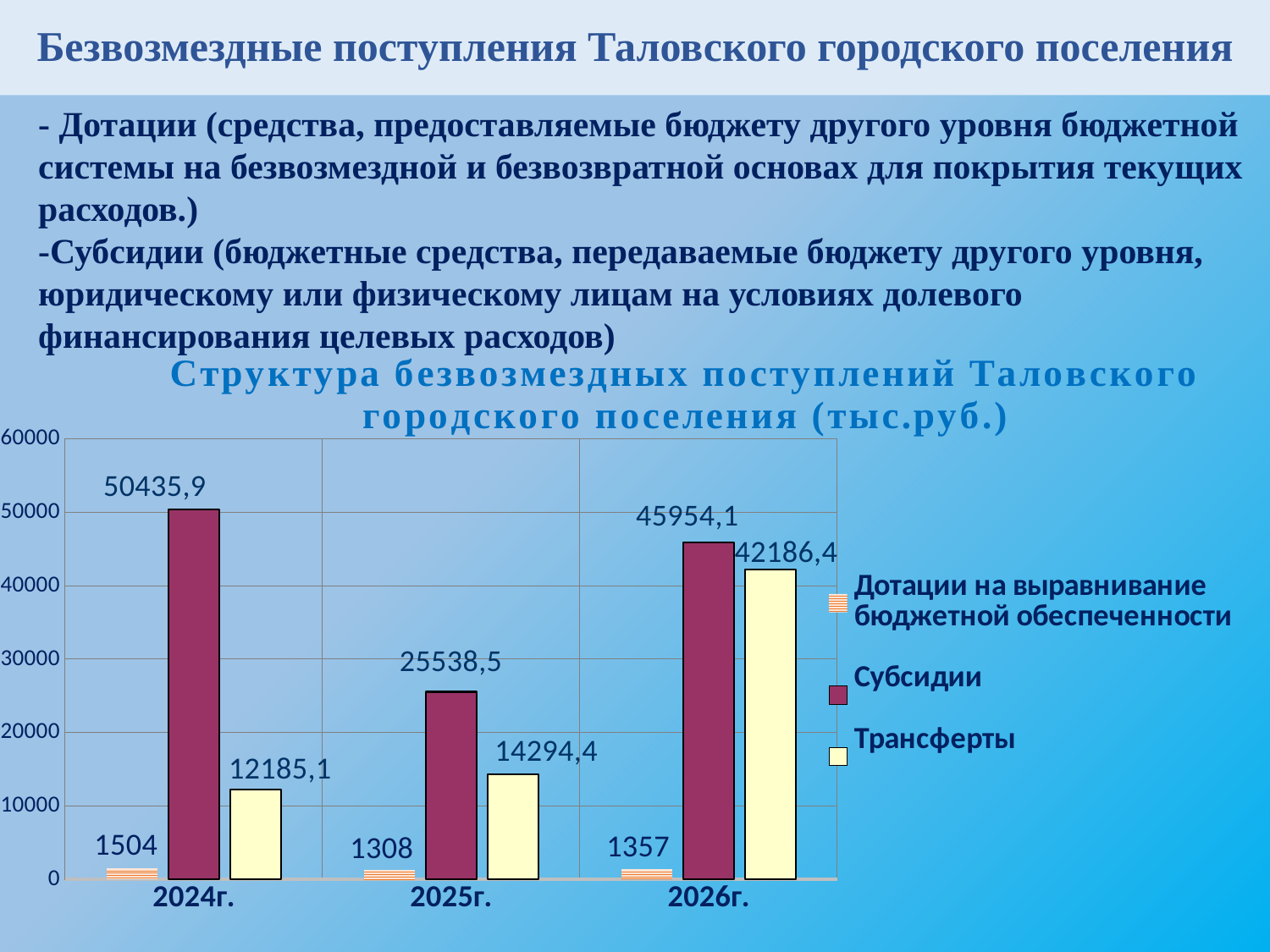
What is the difference between Дотации на выравнивание бюджетной обеспеченности in 2024г. and in 2025г.? 196 In which year is the value of Трансферты the highest? 2026г. In which year is the value of Субсидии the lowest? 2025г. What is the value of Субсидии for 2024г.? 50435,9 What is the value of Дотации на выравнивание бюджетной обеспеченности for 2025г.? 1308 What type of chart is shown on the slide? bar chart How many years are shown on the x axis? 3 Which is larger in 2026г.: Субсидии or Трансферты? Субсидии Is the value of Трансферты for 2025г. greater or less than 20000? less How many series does the legend list? 3 What is the difference between Субсидии in 2024г. and Субсидии in 2026г.? 4481,8 What is the value of Трансферты for 2026г.? 42186,4